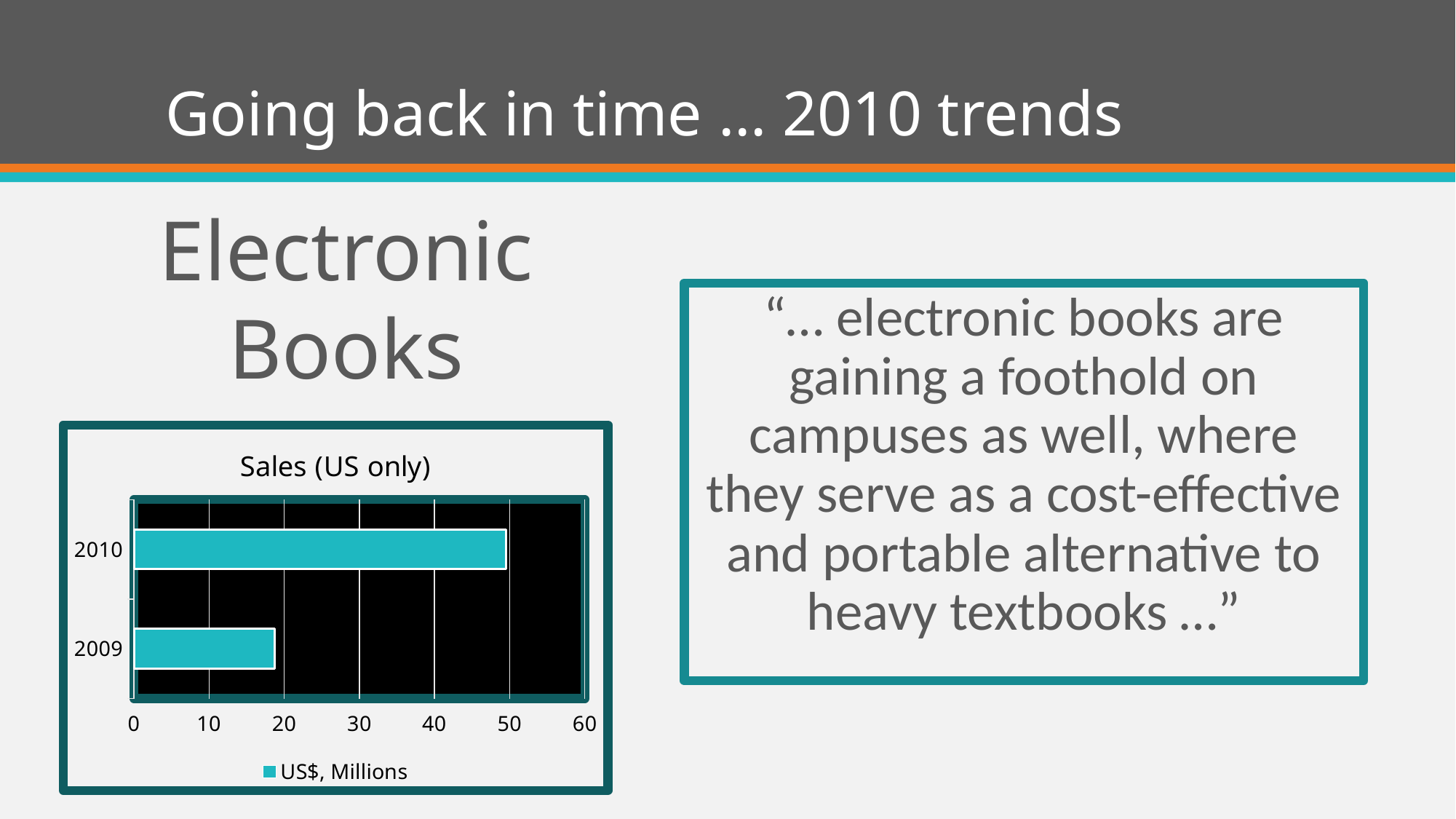
What is the title of the chart? Sales (US only) Which year has the lowest sales value in the chart? 2009 Did sales rise or fall from 2009 to 2010? rise How many categories (years) are plotted in the chart? 2 What is the name of the series shown in the chart legend? US$, Millions Is the sales value for 2010 greater or less than 40? greater Which year has the highest sales value in the chart? 2010 Is the sales value for 2009 greater or less than 10? greater Is the sales value for 2009 greater or less than 30? less Which is larger, the sales value for 2009 or for 2010? 2010 How many series does the chart legend list? 1 What kind of chart is shown on the slide? bar chart